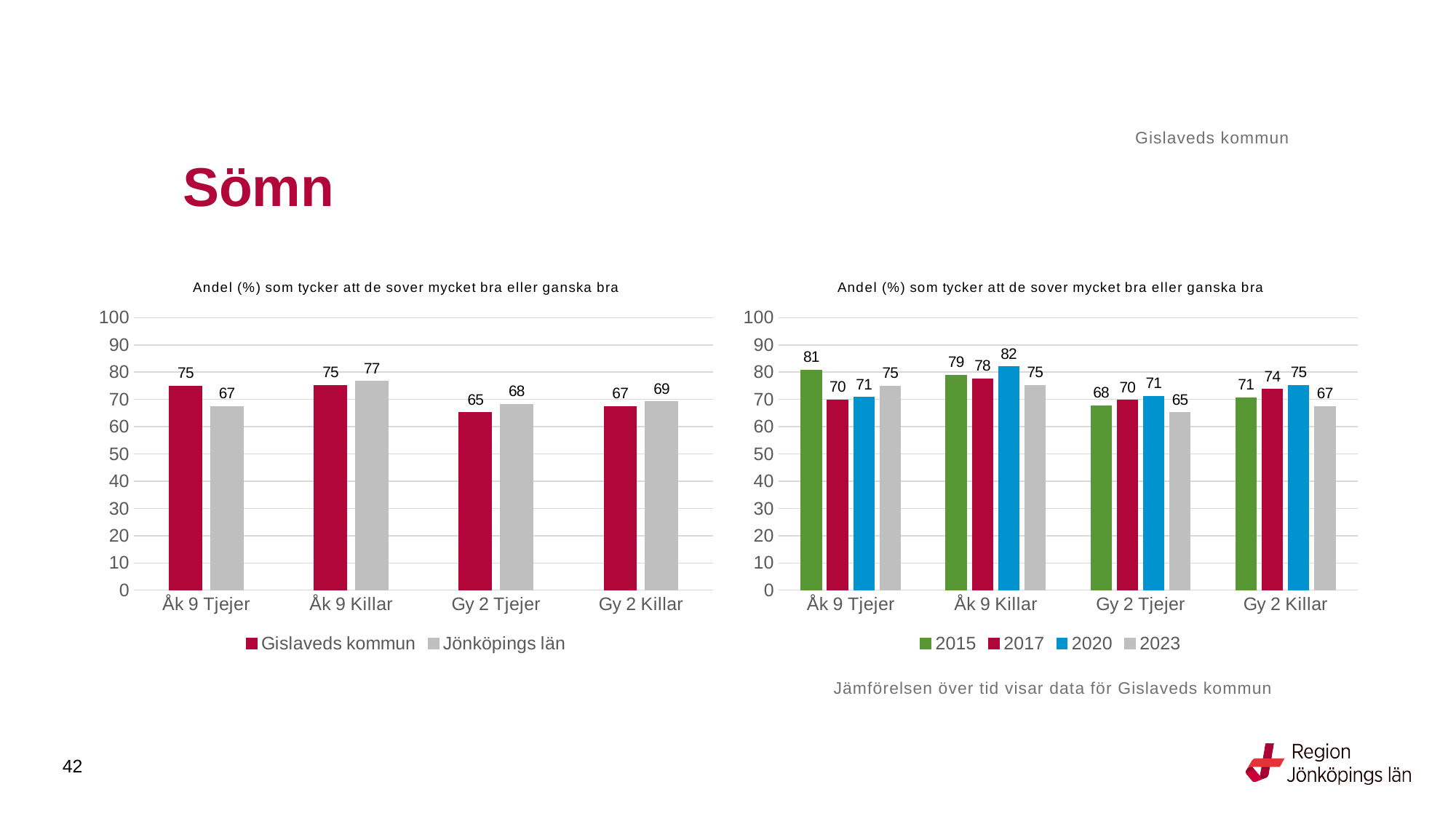
In the right chart, what is the value for 2020 for Åk 9 Killar? 82 In the right chart, which year has the highest value for Åk 9 Tjejer? 2015 In the left chart, how many series does the legend list? 2 In the left chart, which category has the lowest value for Gislaveds kommun? Gy 2 Tjejer In the right chart, how many categories are shown on the x axis? 4 In the right chart, what is the difference between the 2015 and 2023 values for Åk 9 Tjejer? 6 In the right chart, what is the value for 2023 for Gy 2 Tjejer? 65 In the left chart, what is the difference between Jönköpings län and Gislaveds kommun for Åk 9 Tjejer? 8 What kind of chart is the right chart? Bar chart In the right chart, is the value for 2017 larger for Åk 9 Killar or for Gy 2 Tjejer? Åk 9 Killar In the left chart, what is the value for Jönköpings län for Gy 2 Killar? 69 In the left chart, what is the value for Gislaveds kommun for Åk 9 Tjejer? 75